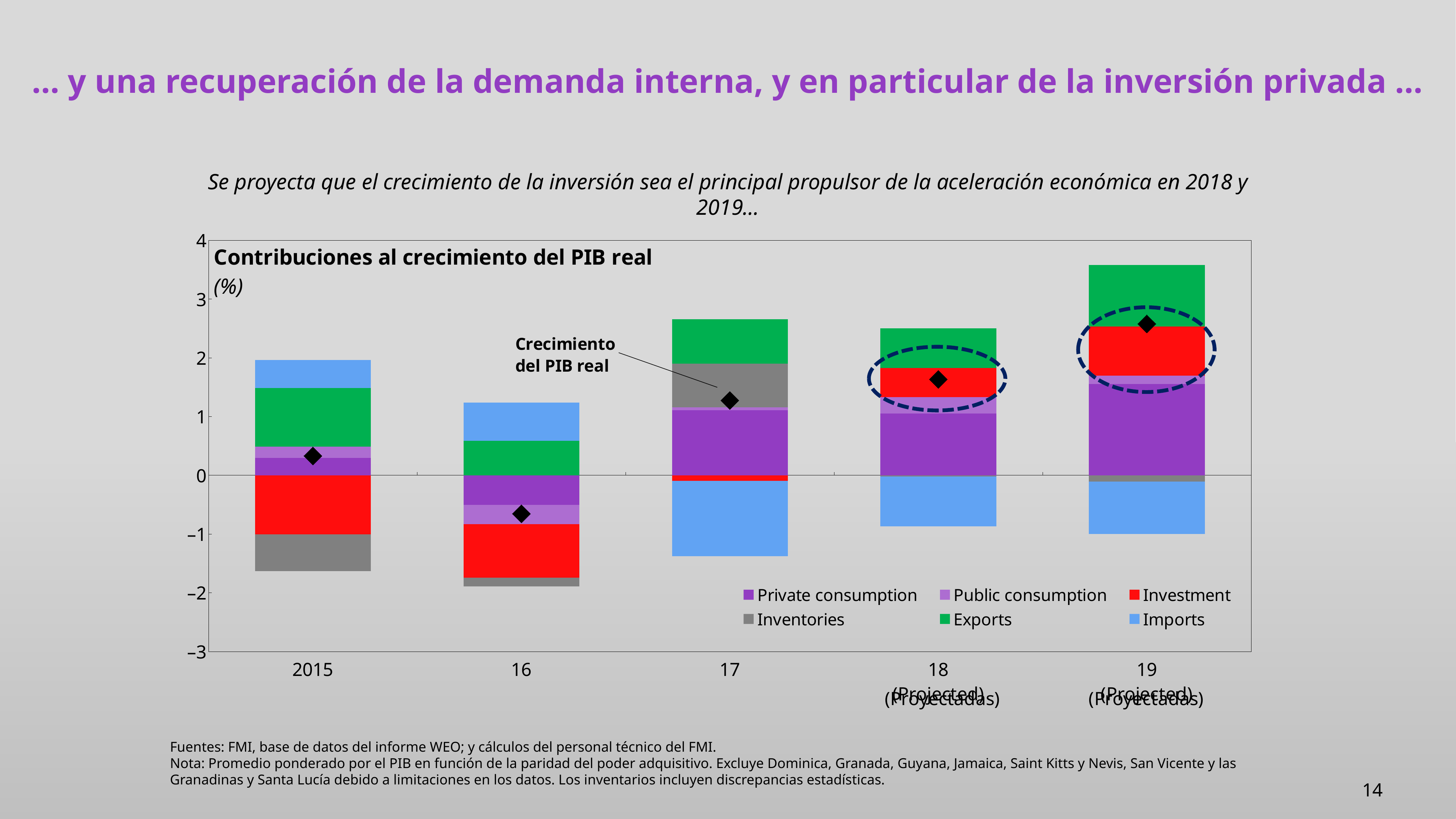
Is the Investment contribution in 2015 greater or less than 0? less Is the real GDP growth marker higher in 2017 or in 2019 (Projected)? 2019 (Projected) Is the real GDP growth marker for 2019 (Projected) greater or less than 2? greater In which year is the real GDP growth marker (Crecimiento del PIB real) lowest? 16 How many series does the chart legend list? 6 How many years (bars) are shown on the x axis? 5 Is the real GDP growth marker for 2018 (Projected) greater or less than 1? greater In which year is the real GDP growth marker (Crecimiento del PIB real) highest? 19 (Projected) What is the title of the chart? Contribuciones al crecimiento del PIB real What kind of chart is shown on the slide? Stacked bar chart From 2016 to 2019 (Projected), does the real GDP growth marker rise or fall? Rise Which colour represents Investment in the chart? Red